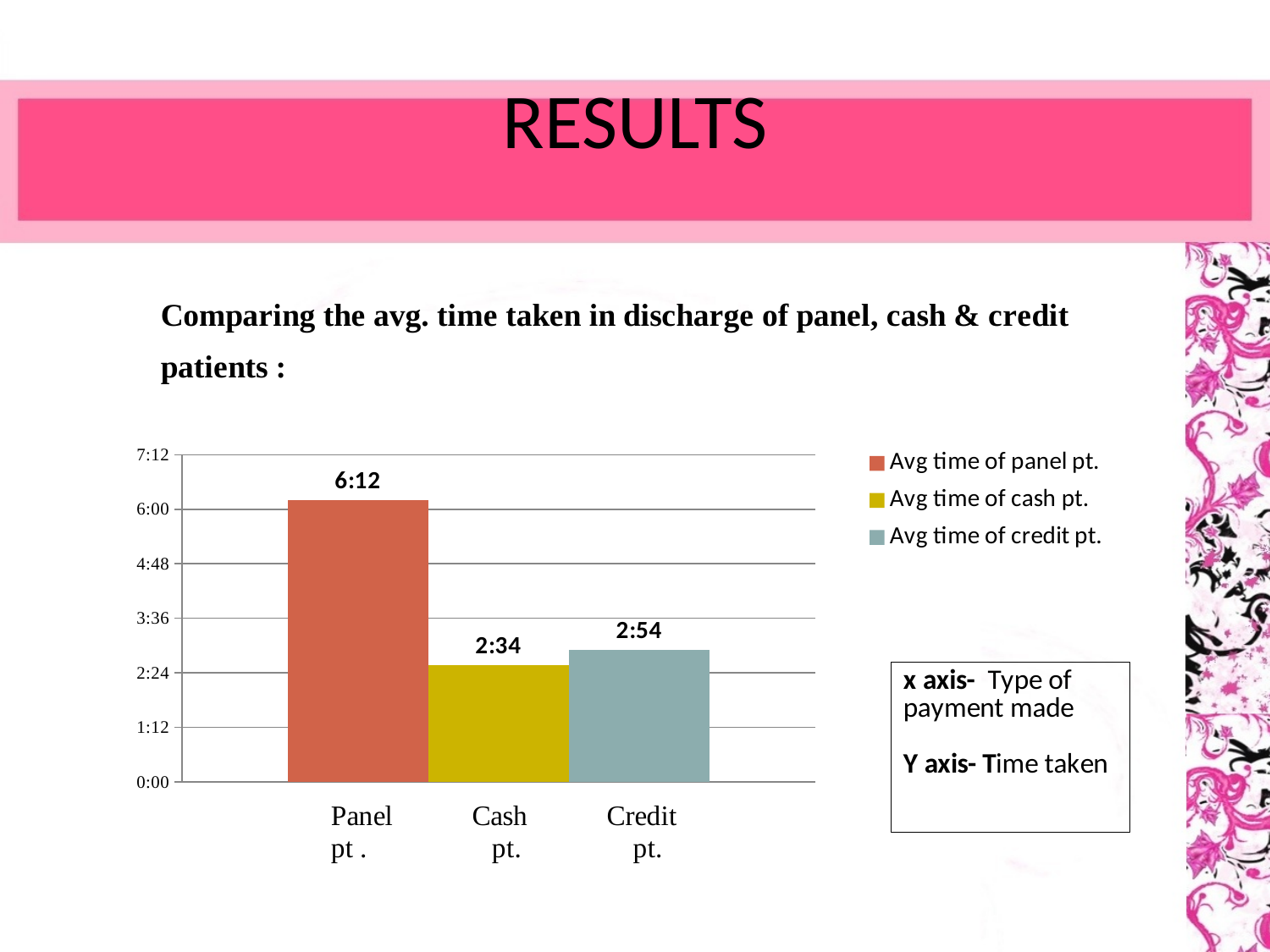
How many categories are shown on the x axis of the chart? 3 What is the average time for cash patients shown on the chart? 2:34 Which type of patient has the lowest average time? Cash pt. Which type of patient has the highest average time? Panel pt. Which is larger, the average time for credit patients or for cash patients? Credit pt. What kind of chart is shown on the slide? Bar chart What is the average time for panel patients shown on the chart? 6:12 Is the value for panel patients greater or less than 6:00? greater What is the difference between the average time of panel patients and cash patients? 3:38 How many entries does the chart legend list? 3 What is the difference between the average time of credit patients and cash patients? 0:20 What is the average time for credit patients shown on the chart? 2:54